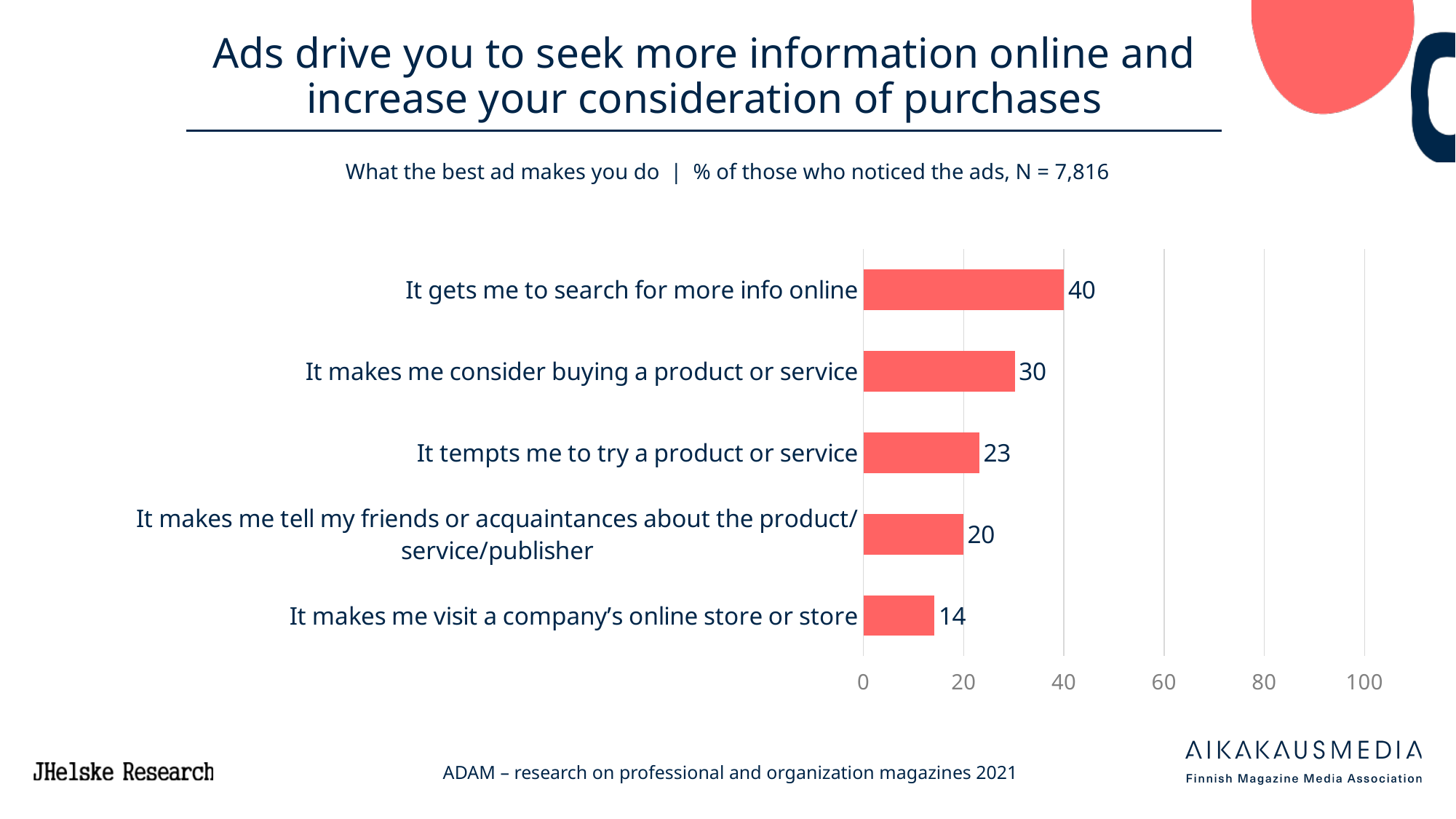
What is the highest value shown on the x axis of the chart? 100 What is the difference between the values for "It tempts me to try a product or service" and "It makes me visit a company's online store or store"? 9 Which category has the highest value? It gets me to search for more info online How many categories are shown in the chart? 5 What is the value for "It makes me visit a company's online store or store"? 14 What kind of chart is shown on the slide? Bar chart What is the difference between the values for "It gets me to search for more info online" and "It makes me consider buying a product or service"? 10 What is the value for "It makes me consider buying a product or service"? 30 What is the value for "It gets me to search for more info online"? 40 Which category has the lowest value? It makes me visit a company's online store or store What is the value for "It makes me tell my friends or acquaintances about the product/service/publisher"? 20 Which is larger: the value for "It tempts me to try a product or service" or the value for "It makes me tell my friends or acquaintances about the product/service/publisher"? It tempts me to try a product or service